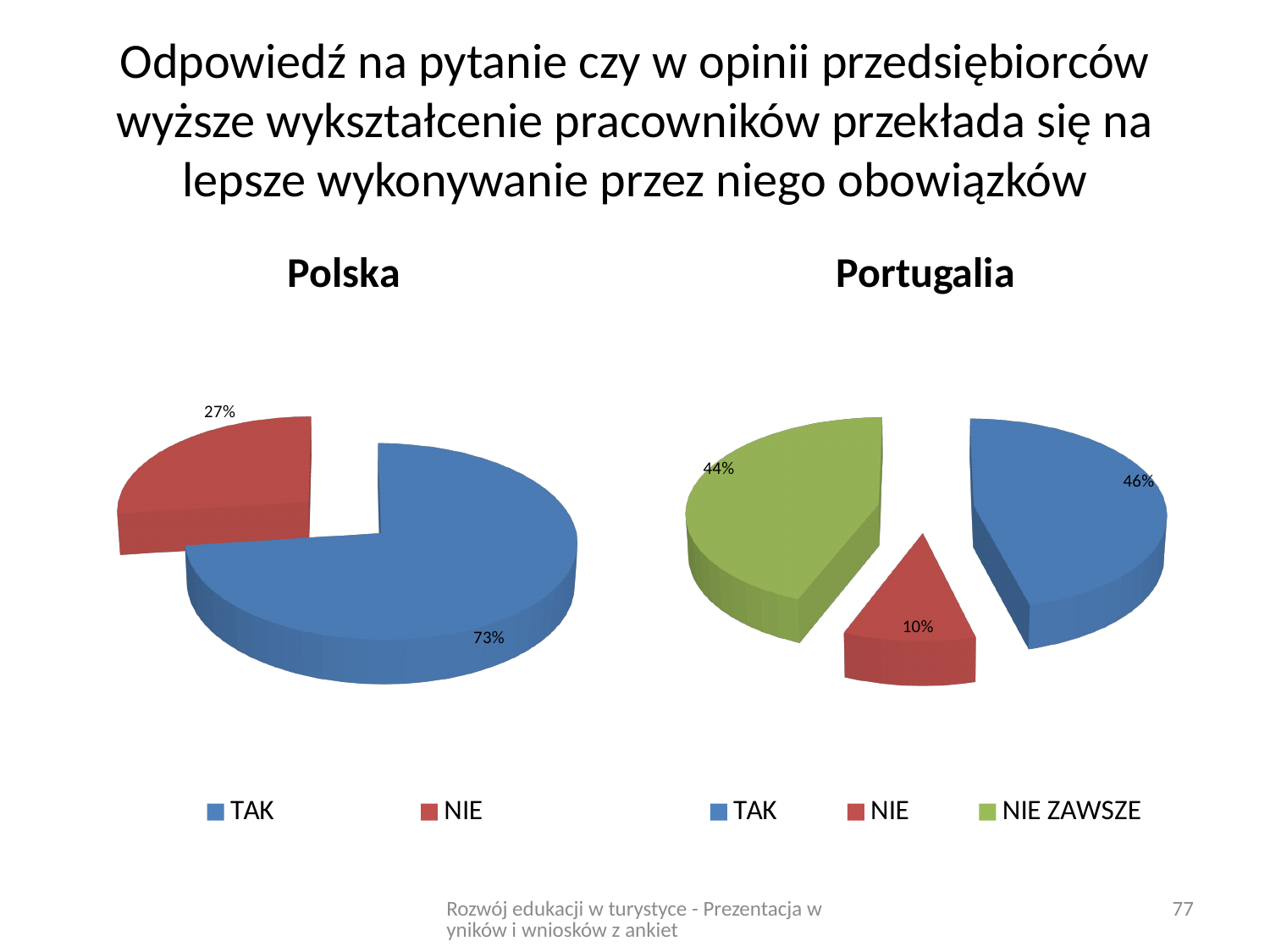
What type of chart is the Polska chart? Pie chart In the Polska chart, what share of respondents answered TAK? 73% In the Polska chart, which answer has the largest share? TAK In the Portugalia chart, what share of respondents answered TAK? 46% Which chart has the larger share for TAK, Polska or Portugalia? Polska In the Portugalia chart, what colour is the NIE ZAWSZE slice? Green In the Polska chart, what share of respondents answered NIE? 27% In the Portugalia chart, what share of respondents answered NIE? 10% In the Portugalia chart, what share of respondents answered NIE ZAWSZE? 44% In the Portugalia chart, which answer has the smallest share? NIE How many categories does the Portugalia chart's legend list? 3 In the Polska chart, what is the difference in percentage points between TAK and NIE? 46